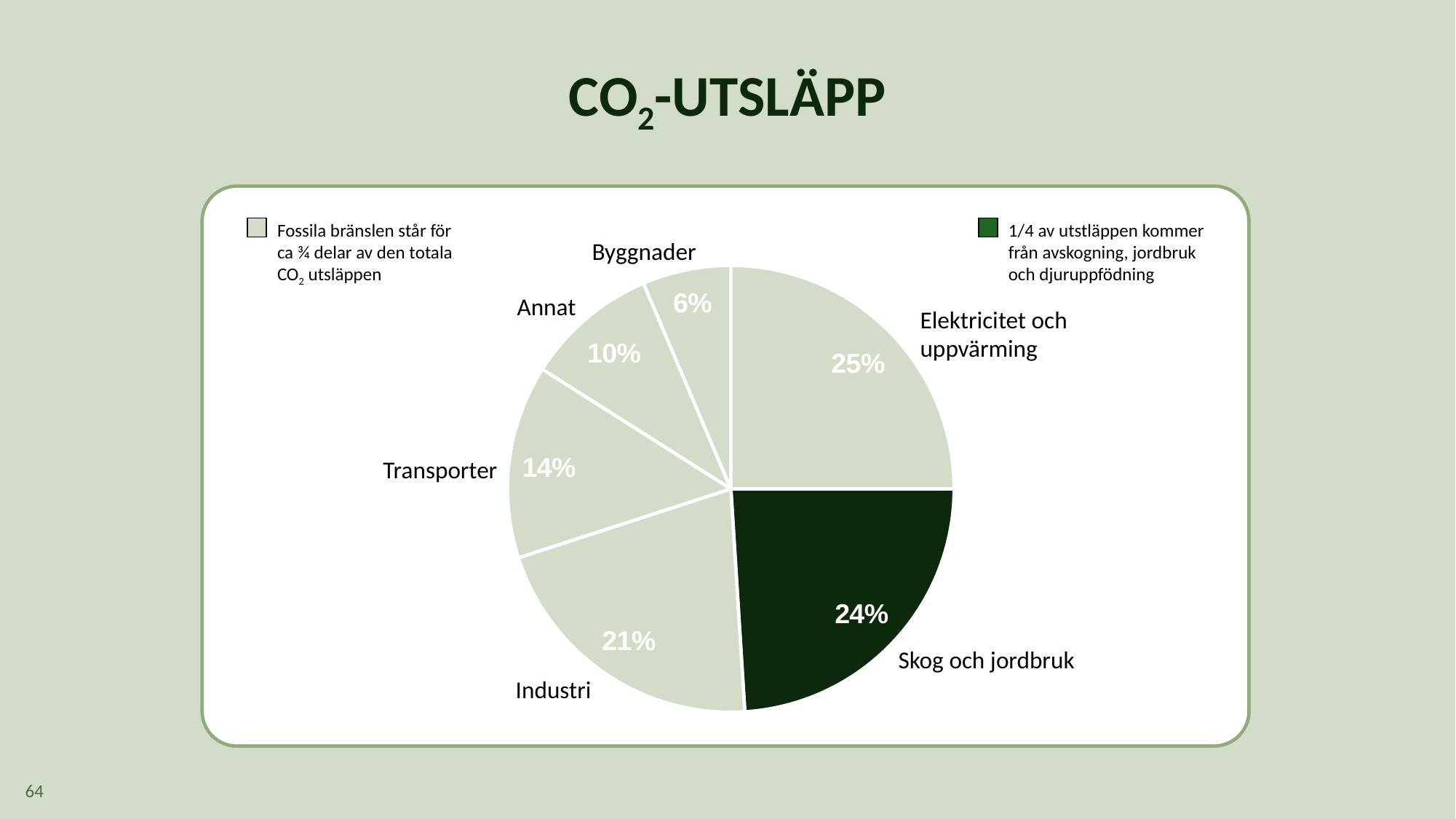
What percentage is shown for Skog och jordbruk? 24% Which category has the largest slice of the pie? Elektricitet och uppvärming What percentage is shown for Transporter? 14% Which is larger, the share for Annat or the share for Byggnader? Annat What share of CO2 emissions does Elektricitet och uppvärming account for? 25% What kind of chart is shown on the slide? pie chart Which category has the smallest slice of the pie? Byggnader How many categories are shown in the pie chart? 6 What percentage is shown for Industri? 21% What percentage is shown for Byggnader? 6% What is the difference in percentage points between Industri and Transporter? 7 Which slice of the pie is coloured dark green? Skog och jordbruk